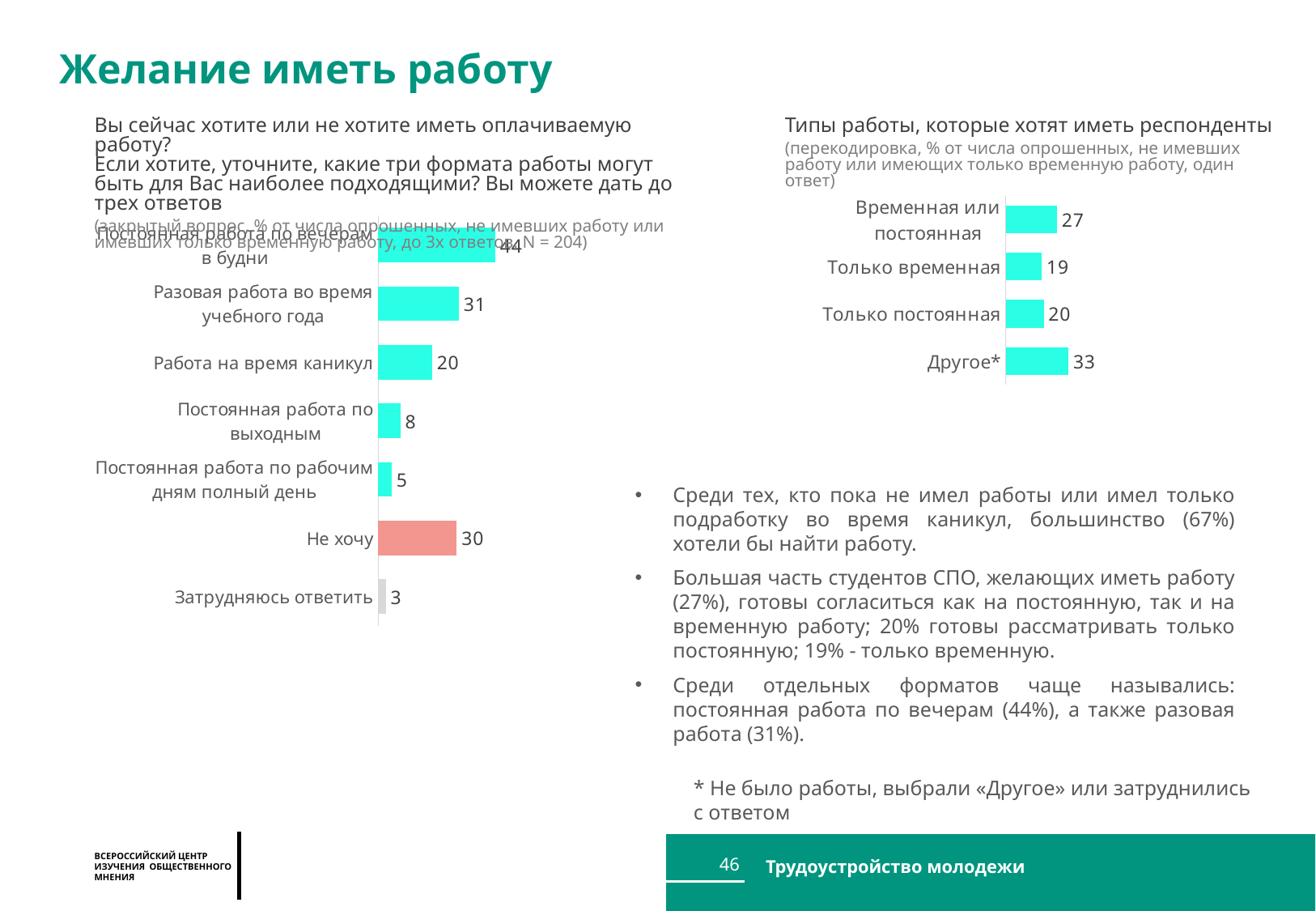
In the right chart «Типы работы, которые хотят иметь респонденты», which category has the highest value? Другое* In the left chart, which category has the highest value? Постоянная работа по вечерам в будни In the left chart, which is larger: «Разовая работа во время учебного года» or «Не хочу»? Разовая работа во время учебного года In the left chart, what is the difference between «Работа на время каникул» and «Постоянная работа по выходным»? 12 In the right chart «Типы работы, которые хотят иметь респонденты», what is the difference between «Другое*» and «Временная или постоянная»? 6 In the right chart «Типы работы, которые хотят иметь респонденты», what is the value for «Только временная»? 19 In the left chart, what is the value for «Разовая работа во время учебного года»? 31 How many categories are shown in the left chart? 7 How many categories are shown in the right chart «Типы работы, которые хотят иметь респонденты»? 4 In the left chart, what is the value for «Не хочу»? 30 What type of chart is the left chart? Bar chart In the left chart, which category has the lowest value? Затрудняюсь ответить